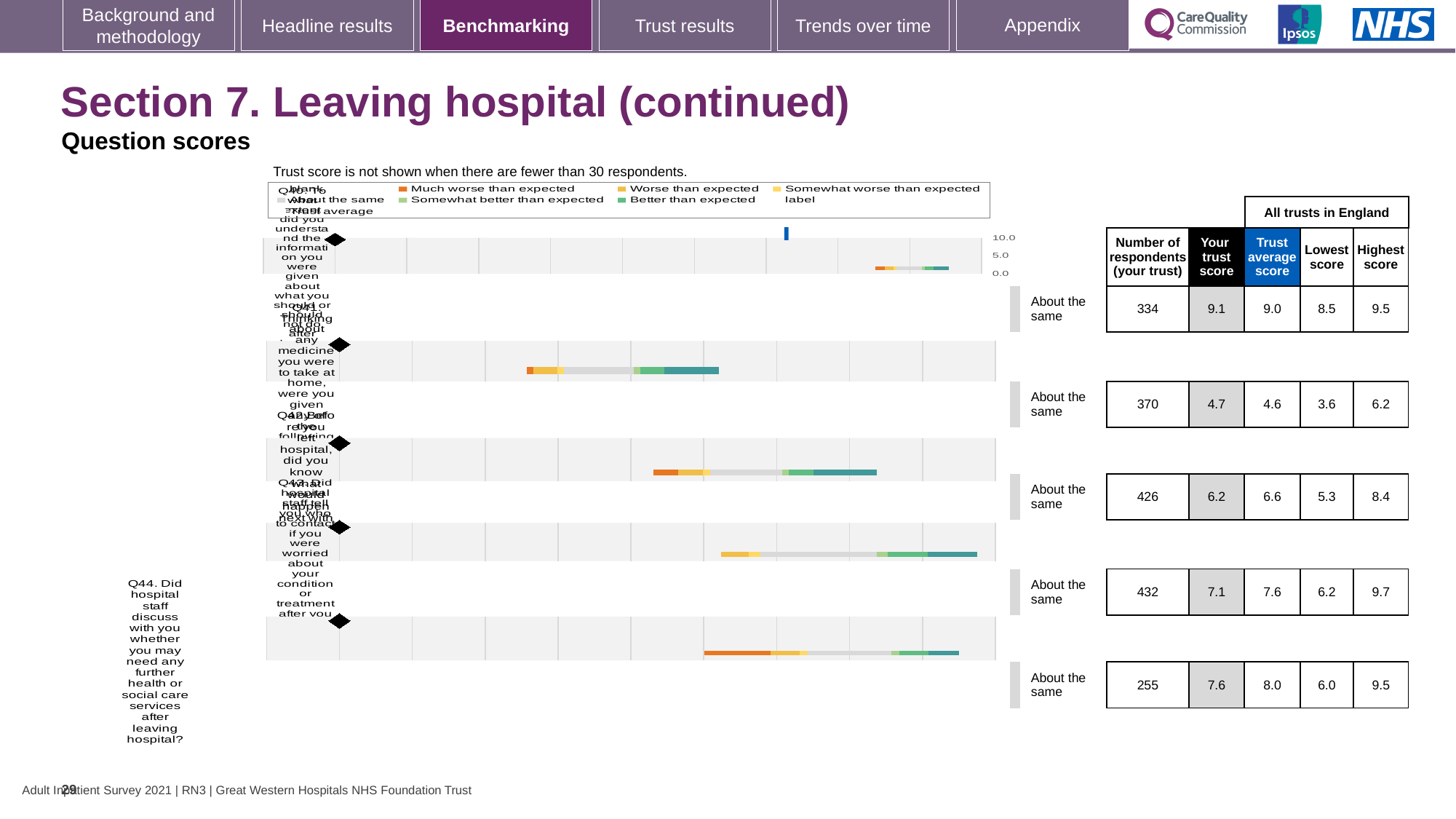
What benchmark category is shown next to the chart for Q44 (further health or social care services after leaving hospital)? About the same According to the table beside the charts, how many respondents answered Q44 (further health or social care services after leaving hospital)? 255 What is the highest value shown on the score axis of the top chart? 10.0 In the legend, which colour represents 'Better than expected'? teal What kind of chart is used to show the question scores on this slide? bar chart According to the table beside the charts, what is the trust score for Q44 (further health or social care services after leaving hospital)? 7.6 How many question rows (charts) are shown in the benchmarking section of this slide? 5 In the legend, which colour represents 'Much worse than expected'? orange